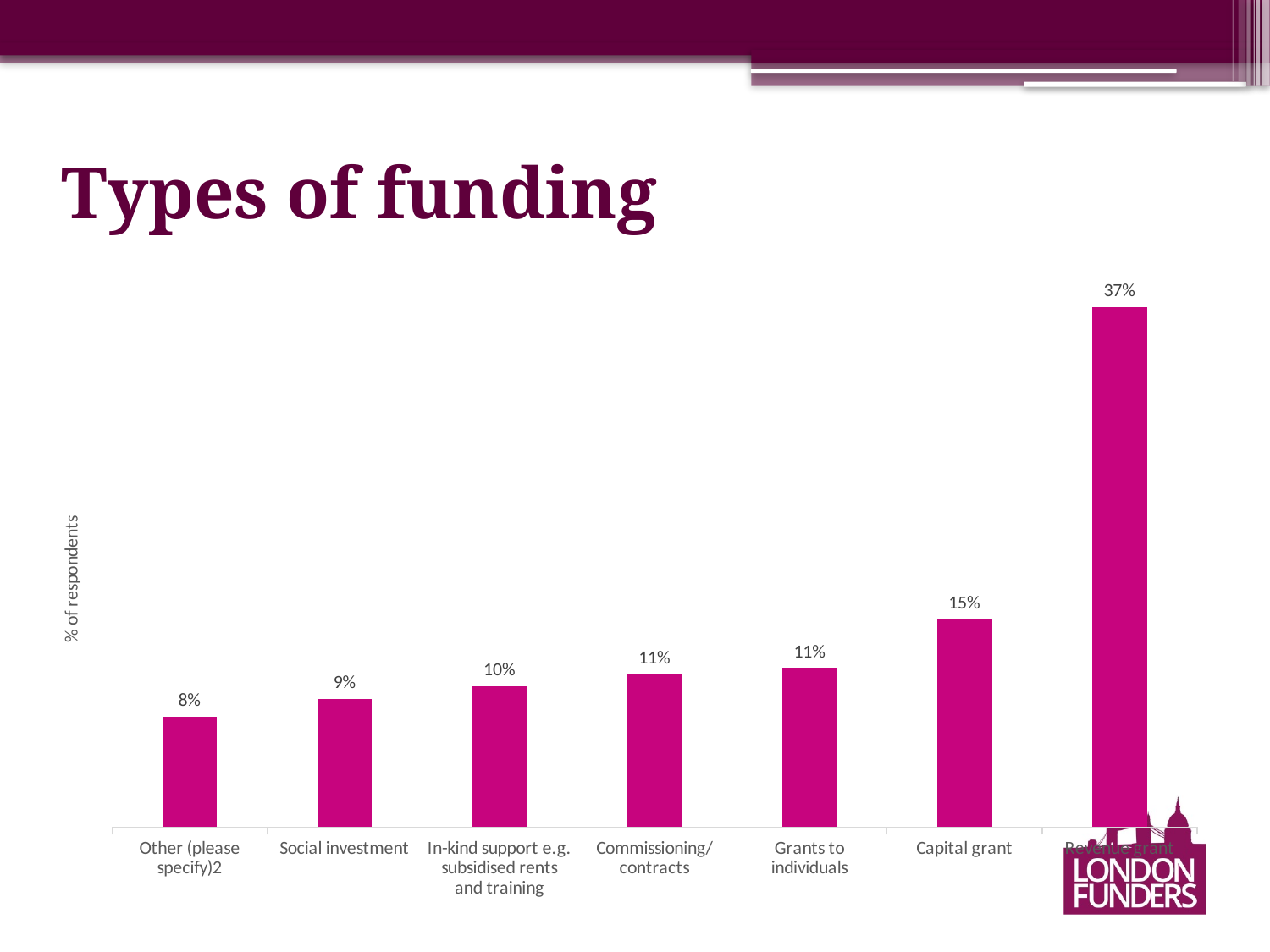
What is the label on the vertical axis of the chart? % of respondents What percentage of respondents is shown for Capital grant? 15% What value is shown for Social investment? 9% How many types of funding are shown in the chart? 7 Which is larger, the value for Commissioning/contracts or the value for Social investment? Commissioning/contracts What value is shown for Grants to individuals? 11% What is the difference between the values for Revenue grant and Capital grant? 22% What is the difference between the values for Capital grant and Social investment? 6% What percentage is shown for In-kind support e.g. subsidised rents and training? 10% Which category has the lowest percentage of respondents? Other (please specify)2 Which type of funding has the highest percentage of respondents? Revenue grant What kind of chart is shown on the slide? Bar chart